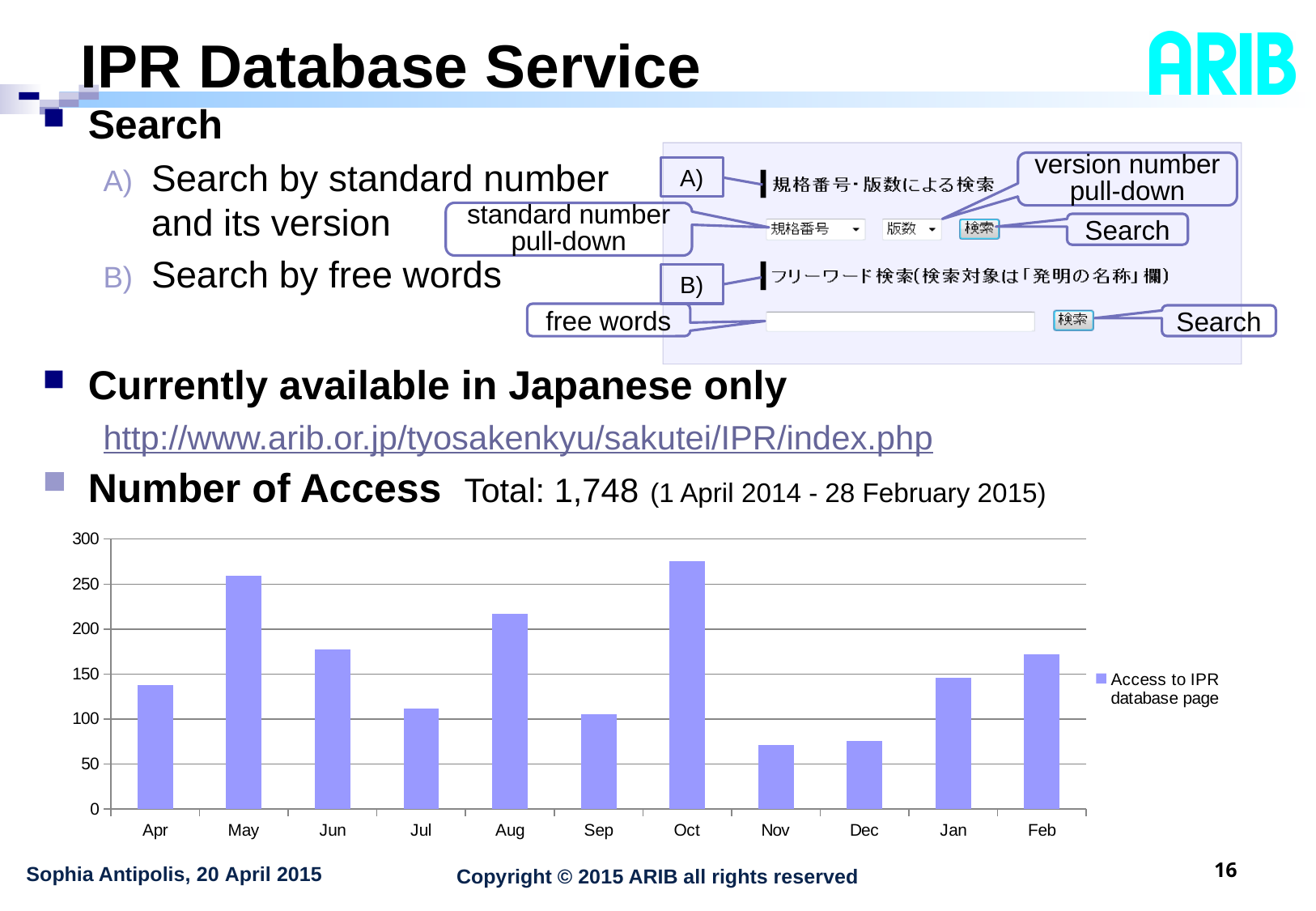
Does the number of accesses rise or fall from Oct to Nov? fall Is the value for Oct greater or less than 250? greater Is the value for Nov greater or less than 100? less What is the name of the series in the chart legend? Access to IPR database page How many months are shown on the x axis of the chart? 11 What kind of chart is shown on the slide? bar chart Which month has the highest number of accesses in the chart? Oct Is the value for Feb greater or less than 150? greater Which month has the larger value, Aug or Jun? Aug How many series does the chart legend list? 1 Which month has the larger value, Sep or Jan? Jan